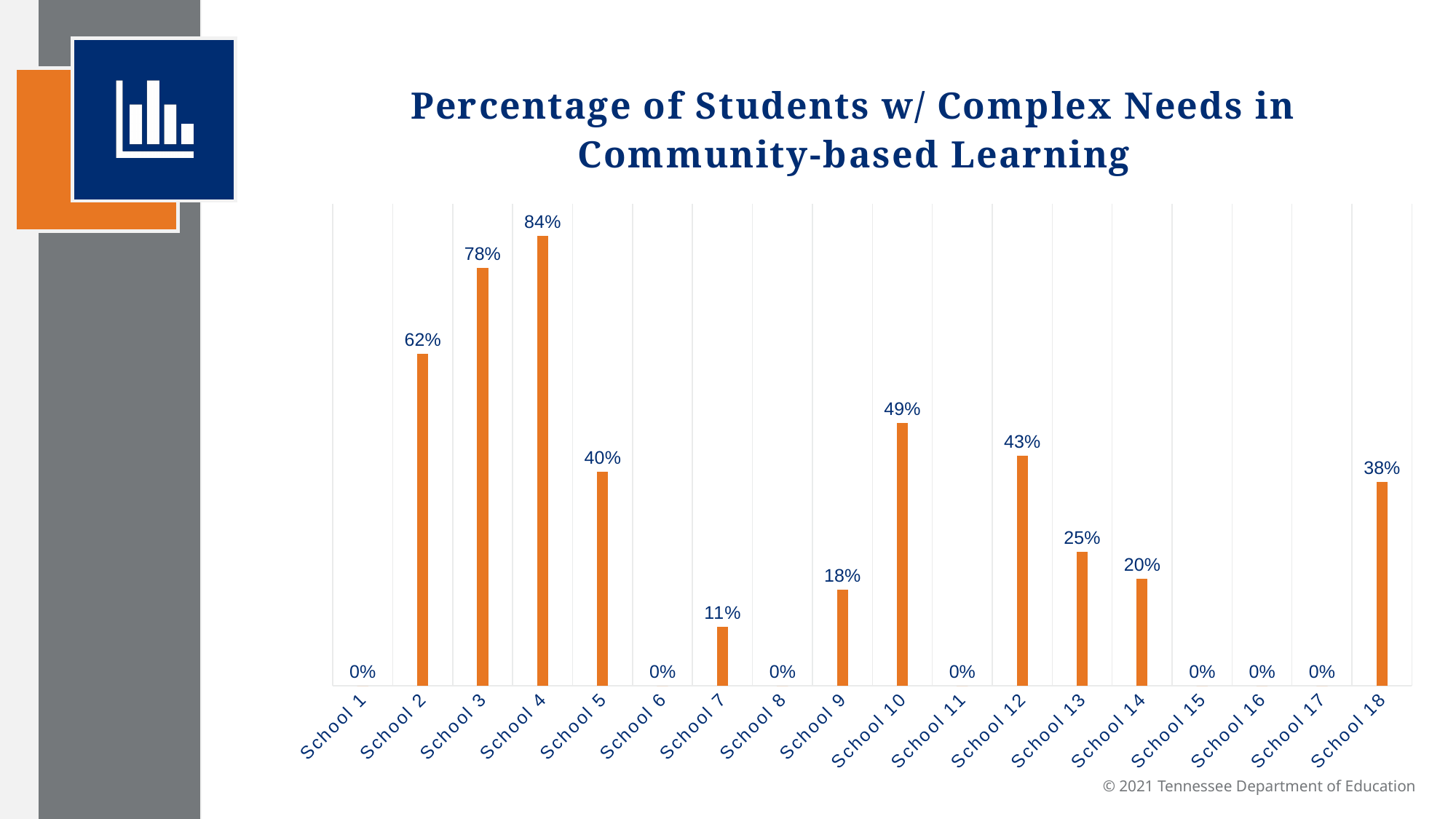
How many schools have a value of 0%? 7 What is the value shown for School 10? 49% What is the percentage of students with complex needs in community-based learning for School 4? 84% How many schools are shown on the x axis of the chart? 18 What is the difference between the values for School 12 and School 13? 18% What is the title of the chart? Percentage of Students w/ Complex Needs in Community-based Learning What is the difference between the values for School 3 and School 2? 16% What kind of chart is shown on the slide? Bar chart What is the value shown for School 18? 38% Which school has the highest percentage of students with complex needs in community-based learning? School 4 Which has a larger value, School 5 or School 12? School 12 Which has a larger value, School 9 or School 14? School 14